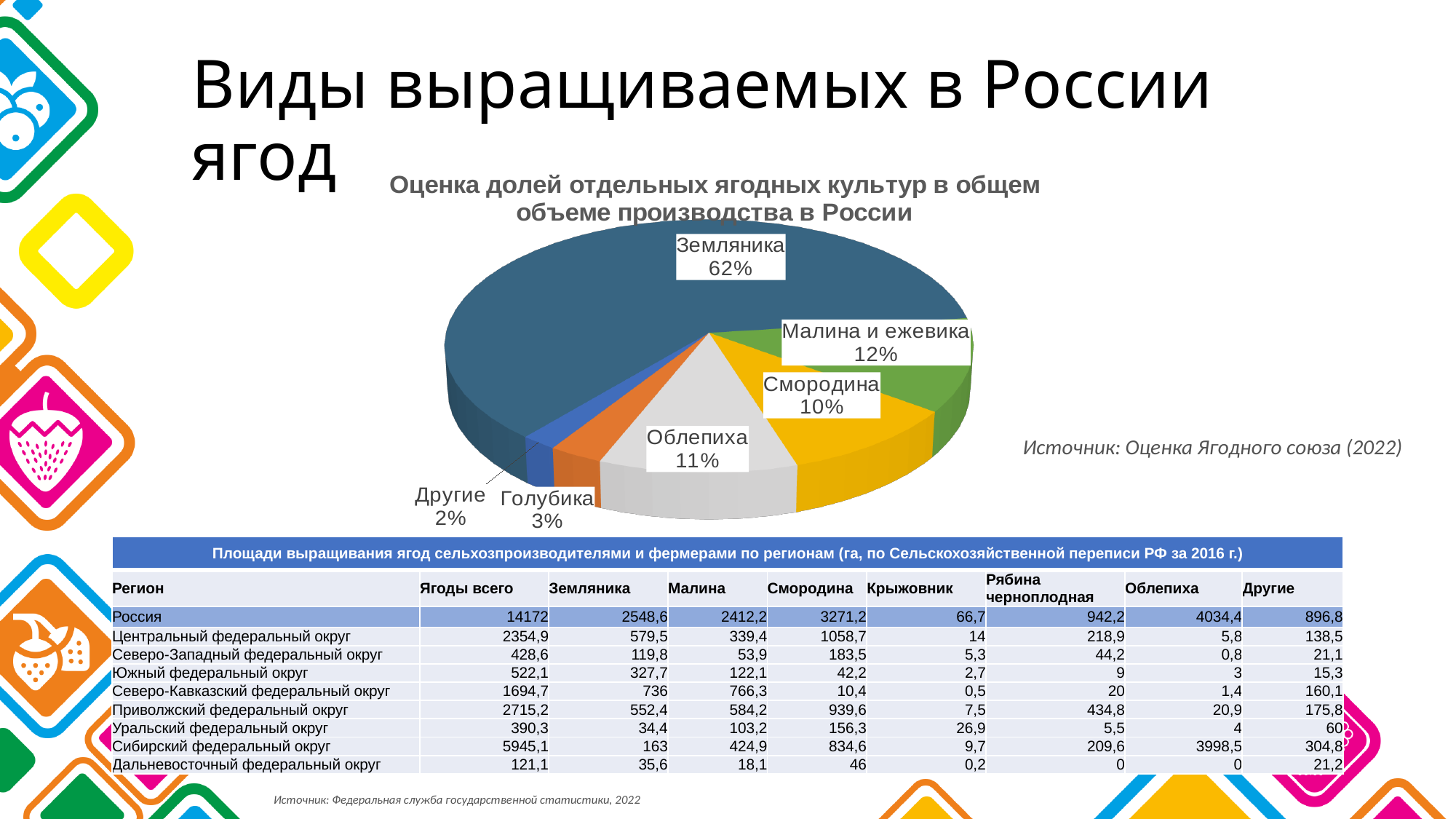
What share of the pie does Голубика have? 3% What is the difference in percentage points between Земляника and Малина и ежевика? 50 What is the title of the pie chart? Оценка долей отдельных ягодных культур в общем объеме производства в России Which category has the largest slice of the pie? Земляника What share of the pie does Смородина have? 10% What share of the pie does Малина и ежевика have? 12% Which category has the smallest slice of the pie? Другие Which is larger, the share for Облепиха or the share for Смородина? Облепиха How many slices does the pie chart have? 6 What share of the pie does Земляника have? 62% What share of the pie does Облепиха have? 11% What kind of chart is shown on the slide? Pie chart